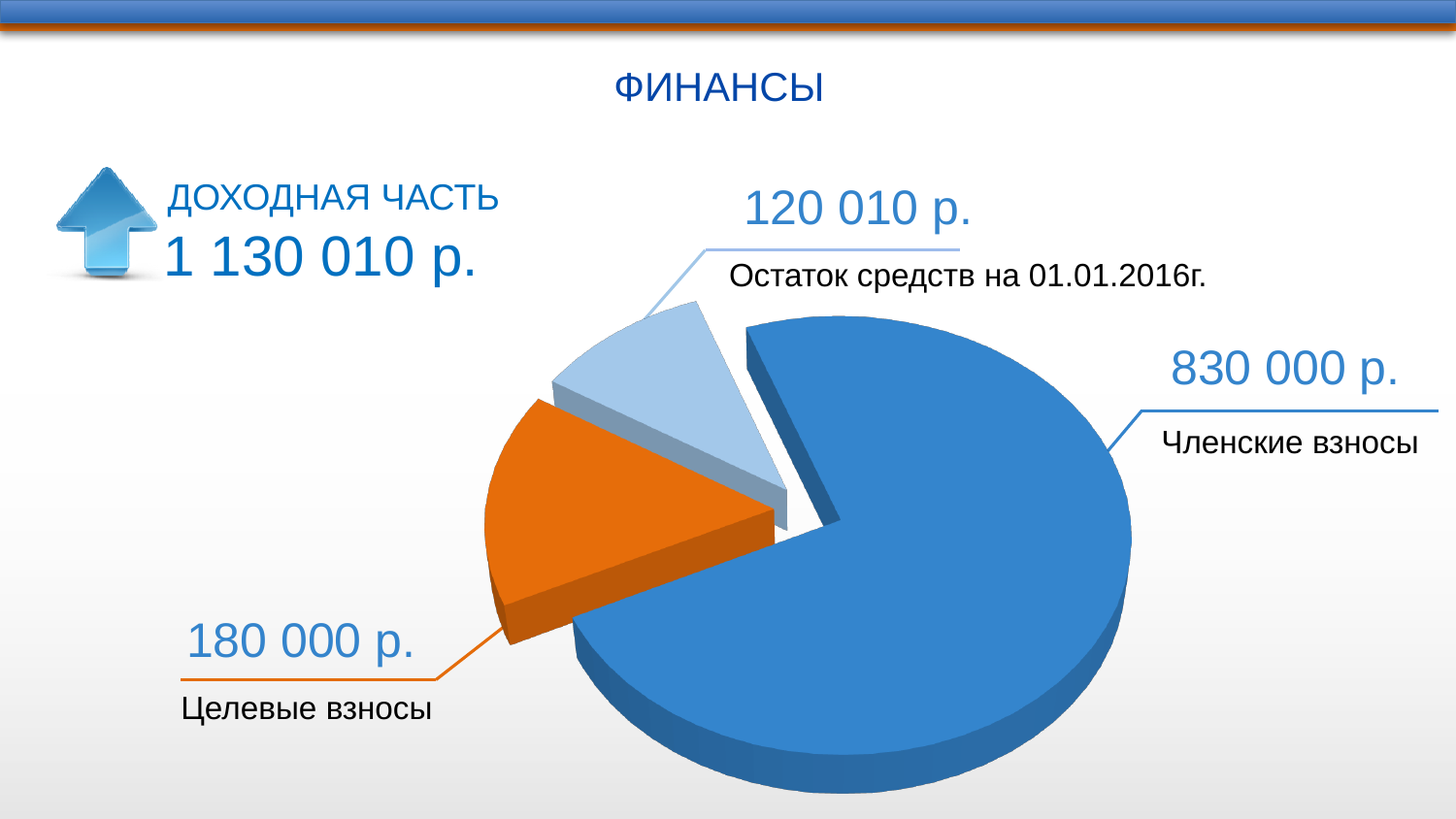
How many slices does the pie chart have? 3 What is the difference between "Членские взносы" and "Целевые взносы"? 650 000 р. What is the difference between "Целевые взносы" and "Остаток средств на 01.01.2016г."? 59 990 р. Which is larger, "Целевые взносы" or "Остаток средств на 01.01.2016г."? Целевые взносы Which slice of the pie chart is the smallest? Остаток средств на 01.01.2016г. Which slice of the pie chart is the largest? Членские взносы What is the value of the "Целевые взносы" slice? 180 000 р. What is the value of the "Членские взносы" slice? 830 000 р. What is the total of all three slices of the pie chart? 1 130 010 р. What is the value of the "Остаток средств на 01.01.2016г." slice? 120 010 р. What colour is the "Целевые взносы" slice? Orange What type of chart is shown on the slide? Pie chart